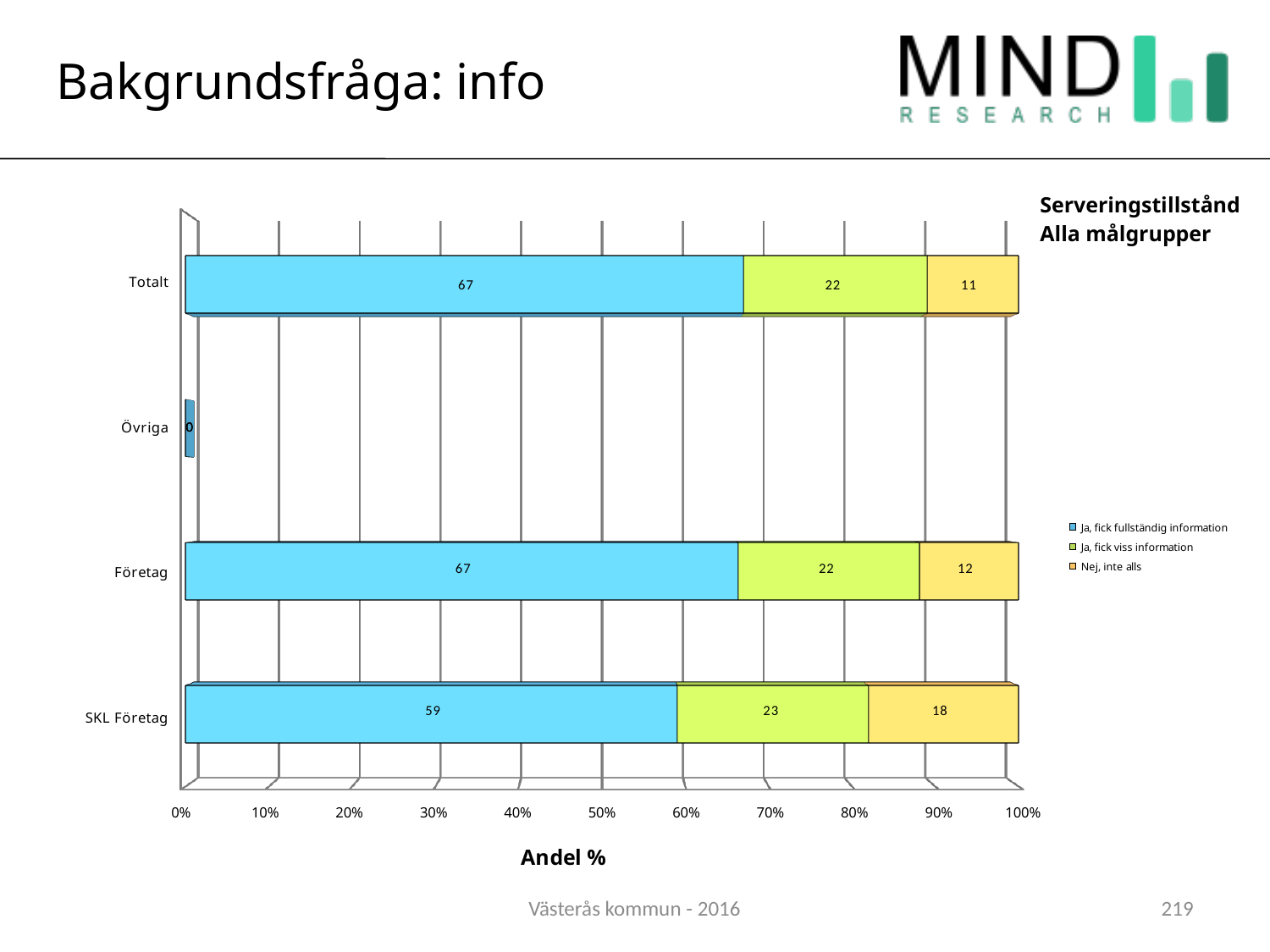
How many categories are shown on the y axis? 4 What kind of chart is shown on the slide? Stacked bar chart Which is larger: the "Nej, inte alls" value for Totalt or for SKL Företag? SKL Företag What is the value shown for Övriga? 0 Which category has the highest value for "Nej, inte alls"? SKL Företag How many series does the legend list? 3 What is the total of the stacked bar for Totalt? 100 What is the value of "Ja, fick viss information" for Totalt? 22 What is the value of "Ja, fick fullständig information" for SKL Företag? 59 What is the label of the x axis? Andel % What is the value of "Nej, inte alls" for Företag? 12 What is the difference between the "Ja, fick fullständig information" values for Företag and SKL Företag? 8